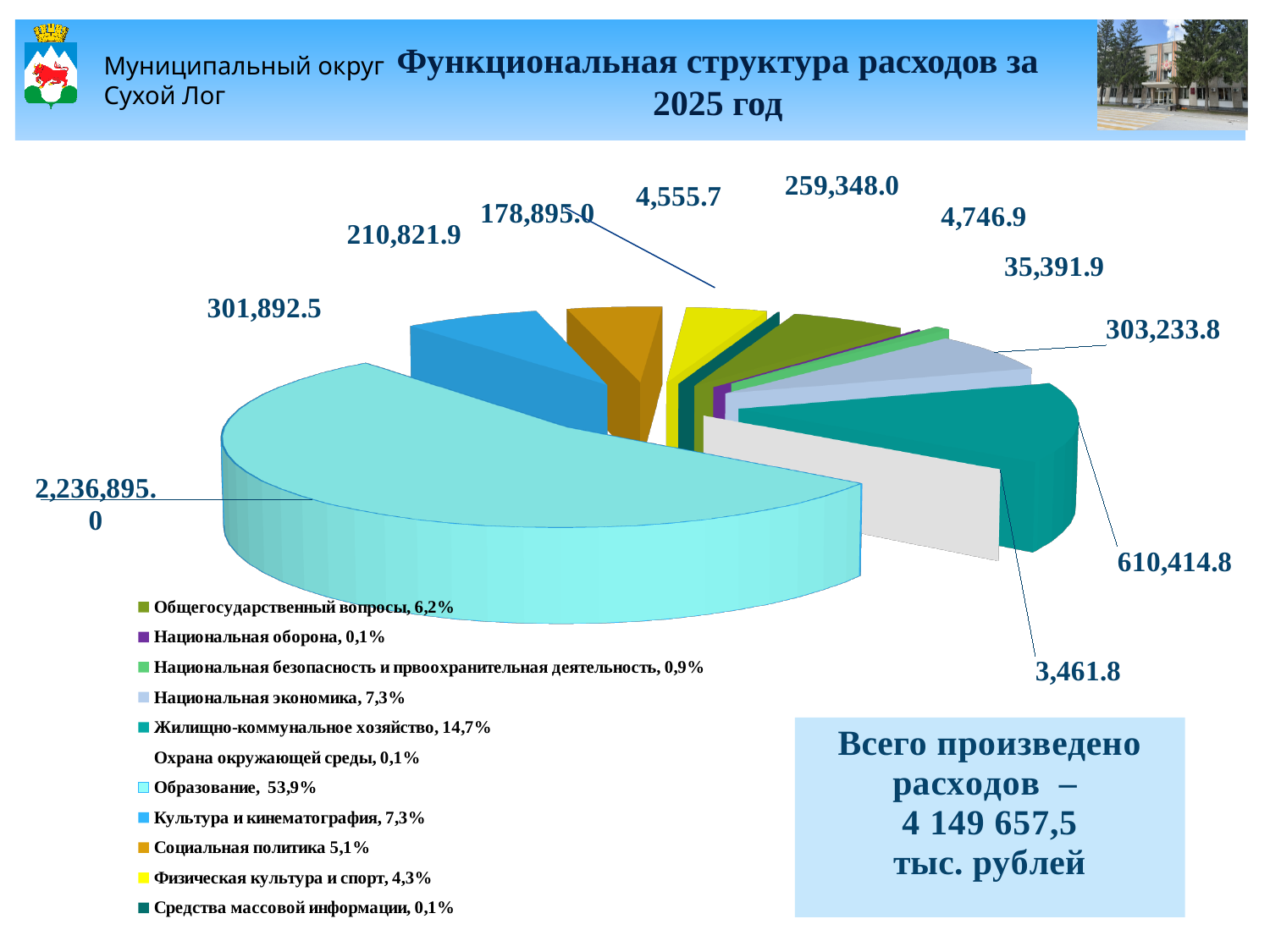
What total expenditure amount is stated in the text box on the slide? 4 149 657,5 тыс. рублей What share does Физическая культура и спорт have according to the legend? 4,3% What is the difference between the labelled values 303,233.8 and 301,892.5? 1,341.3 What share of expenditures does Образование account for according to the legend? 53,9% What kind of chart is shown on the slide? pie chart Which category has the largest share of the pie chart? Образование What share does Жилищно-коммунальное хозяйство have according to the legend? 14,7% What value is labelled on the Жилищно-коммунальное хозяйство slice? 610,414.8 What is the value labelled on the largest slice (Образование)? 2,236,895.0 What is the title of the chart on the slide? Функциональная структура расходов за 2025 год Which is larger: the share of Национальная экономика or the share of Социальная политика? Национальная экономика How many categories does the legend of the pie chart list? 11